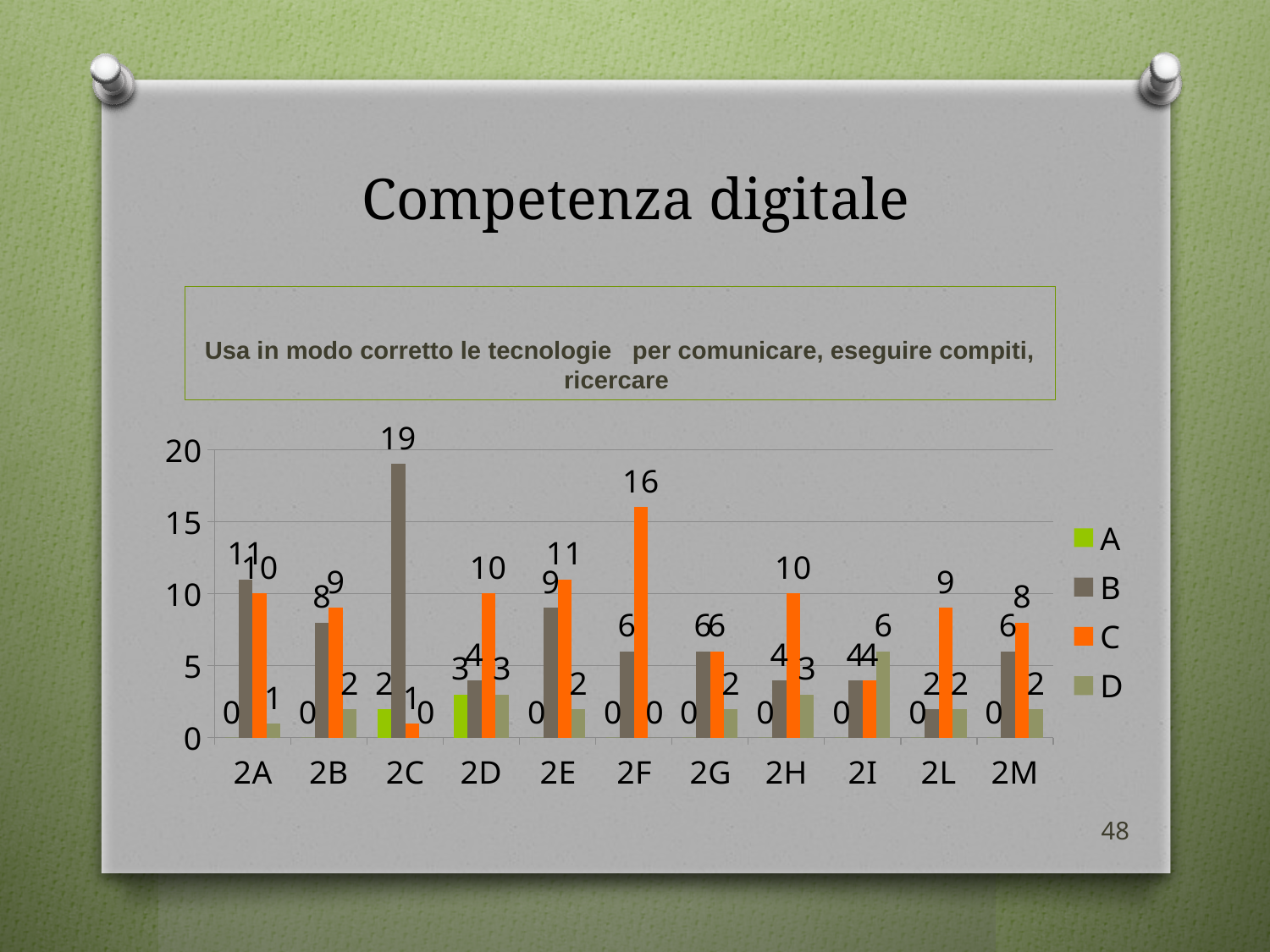
What is the difference between series B and series C for category 2C? 18 What is the value of series B for category 2C? 19 What is the value of series D for category 2I? 6 How many series does the legend list? 4 How many categories are shown on the x axis? 11 For category 2A, which is larger: series B or series C? B Which category has the highest value for series B? 2C What kind of chart is shown on the slide? bar chart Is the value of series B for category 2C greater or less than 15? greater Which category has the highest value for series C? 2F What is the title of the slide? Competenza digitale What is the value of series C for category 2F? 16